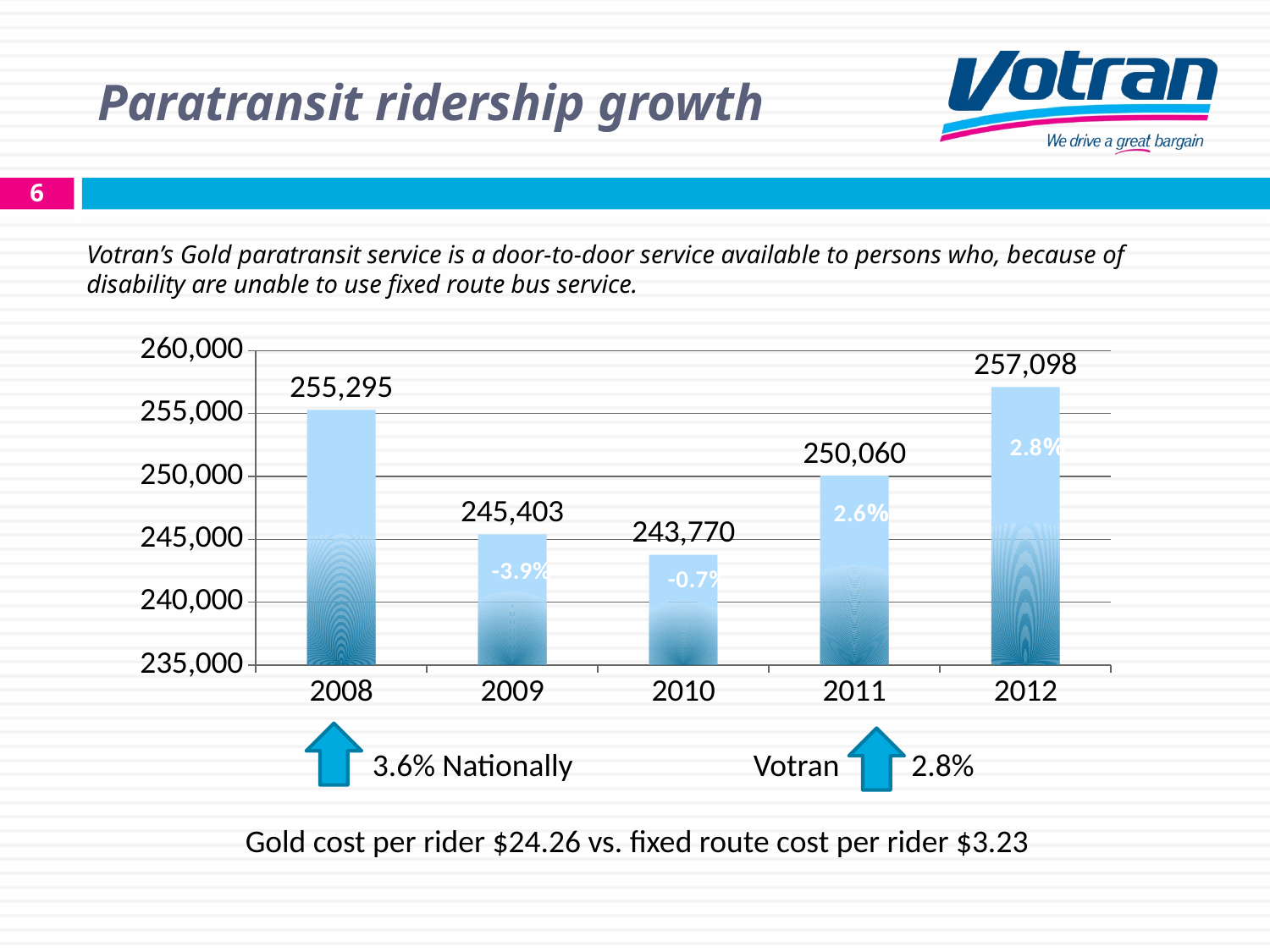
Which year has higher ridership, 2009 or 2011? 2011 What is the paratransit ridership value shown for 2008? 255,295 What is the ridership value shown for 2010? 243,770 What percentage change is printed inside the 2009 bar? -3.9% What is the difference in ridership between 2012 and 2008? 1,803 What is the ridership value shown for 2012? 257,098 What kind of chart is used to show paratransit ridership? bar chart What is the difference in ridership between 2011 and 2010? 6,290 Is the ridership value for 2009 greater or less than 250,000? less How many years are shown on the x axis of the chart? 5 Which year has the highest ridership? 2012 Which year has the lowest ridership? 2010